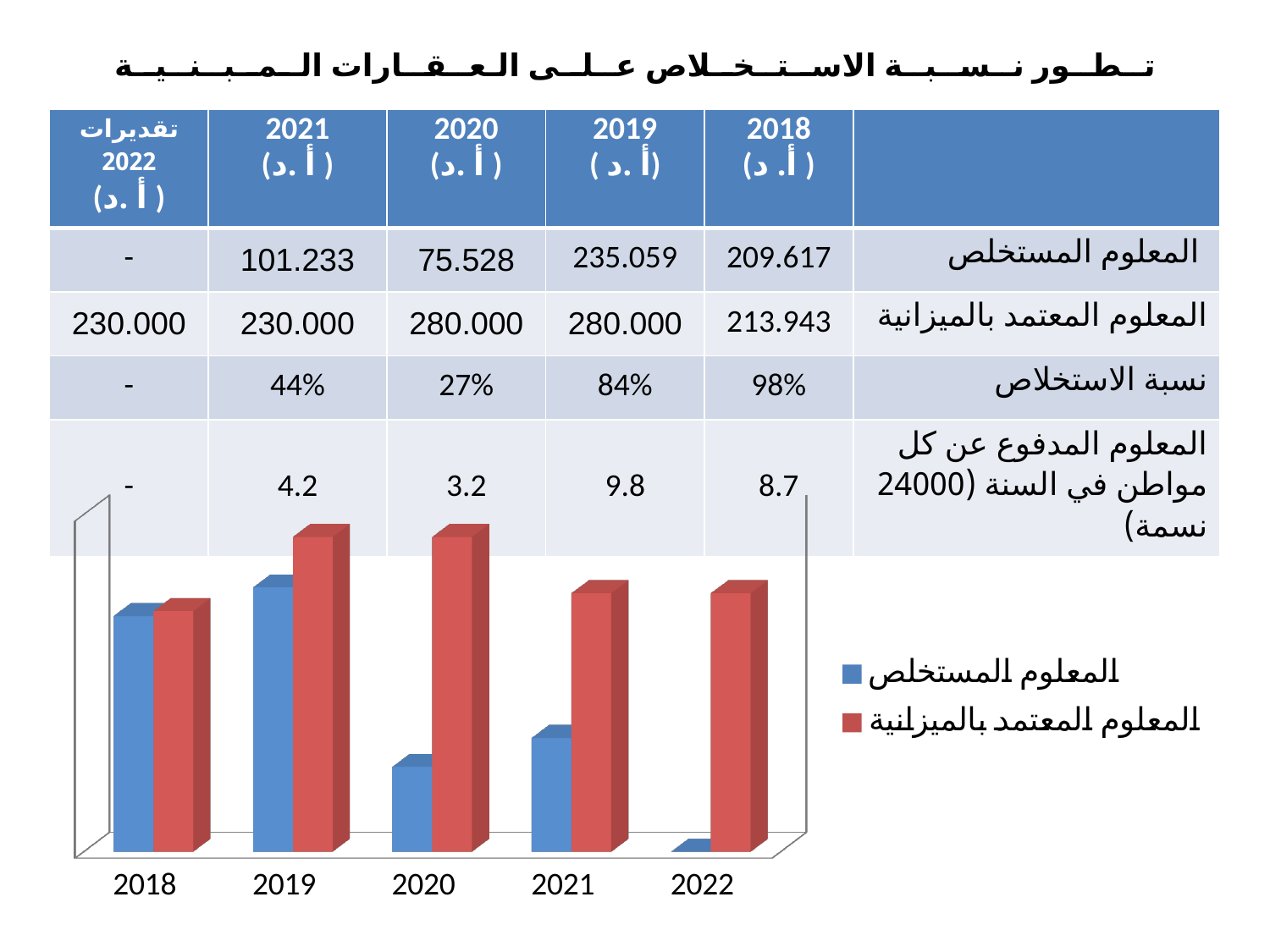
How many years are shown on the x axis of the chart? 5 What is the value of المعلوم المستخلص for 2020 as printed in the table? 75.528 In 2021, which series has the taller bar, المعلوم المستخلص or المعلوم المعتمد بالميزانية? المعلوم المعتمد بالميزانية How many series does the chart legend list? 2 Which year has the lowest bar for المعلوم المعتمد بالميزانية? 2018 Does the bar for المعلوم المستخلص rise or fall from 2020 to 2021? rise In 2020, which series has the taller bar, المعلوم المستخلص or المعلوم المعتمد بالميزانية? المعلوم المعتمد بالميزانية Which series is shown in blue in the chart? المعلوم المستخلص What kind of chart is shown on the slide? bar chart What is the value of المعلوم المعتمد بالميزانية for 2019 as printed in the table? 280.000 Which series is shown in red in the chart? المعلوم المعتمد بالميزانية Does the bar for المعلوم المستخلص rise or fall from 2019 to 2020? fall